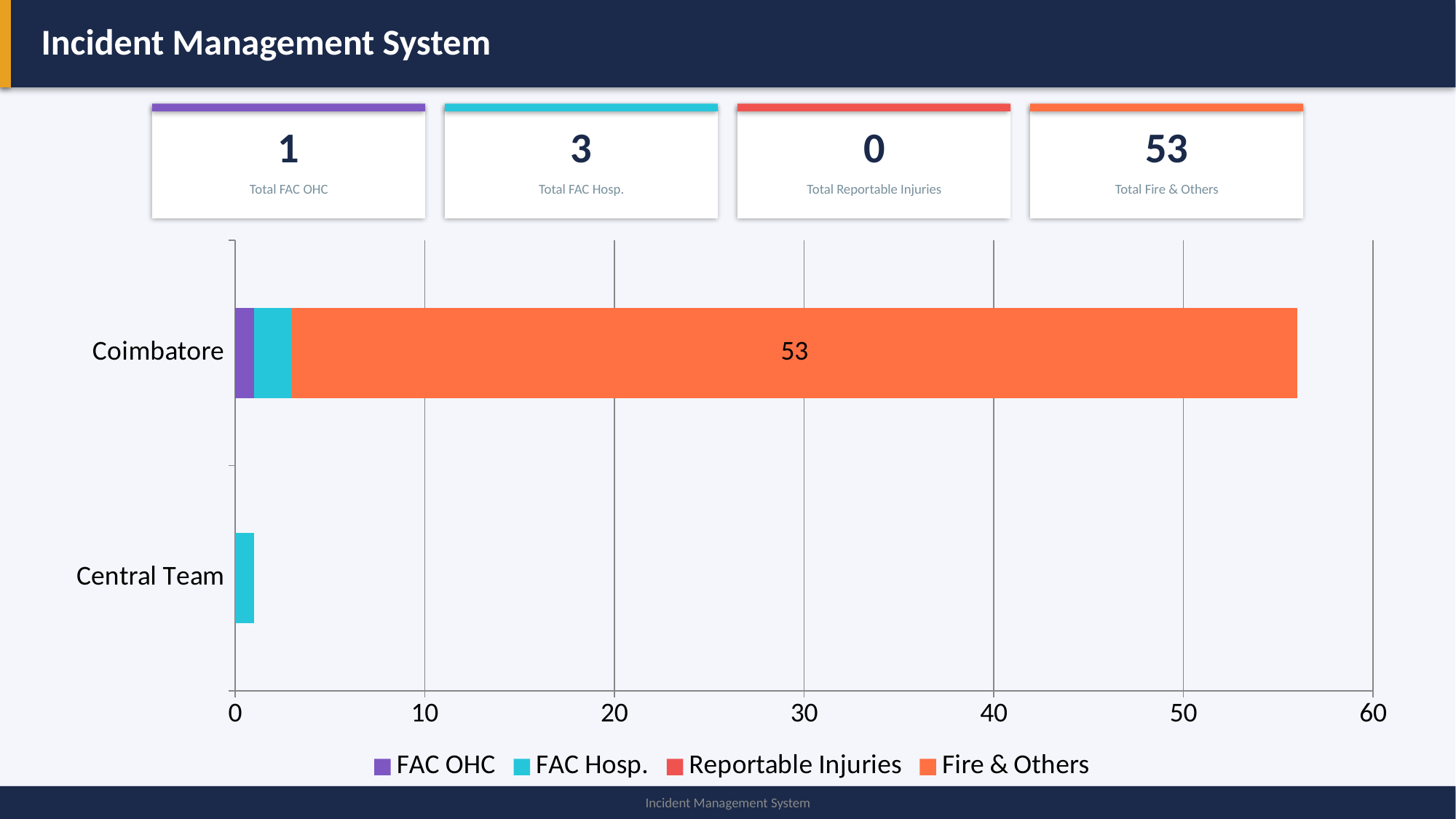
What is the value of Fire & Others for Coimbatore? 53 How many categories are shown on the vertical axis of the chart? 2 Which category has the longest total bar? Coimbatore What kind of chart is shown on the slide? Stacked bar chart Which is larger, the total bar for Coimbatore or the total bar for Central Team? Coimbatore Which series makes up the largest segment of the Coimbatore bar? Fire & Others Which category has the shortest total bar? Central Team Is the total bar length for Coimbatore greater or less than 50? greater What is the highest value shown on the horizontal axis of the chart? 60 Is the total bar length for Central Team greater or less than 10? less What are the four series listed in the chart legend? FAC OHC, FAC Hosp., Reportable Injuries, Fire & Others How many series does the chart legend list? 4